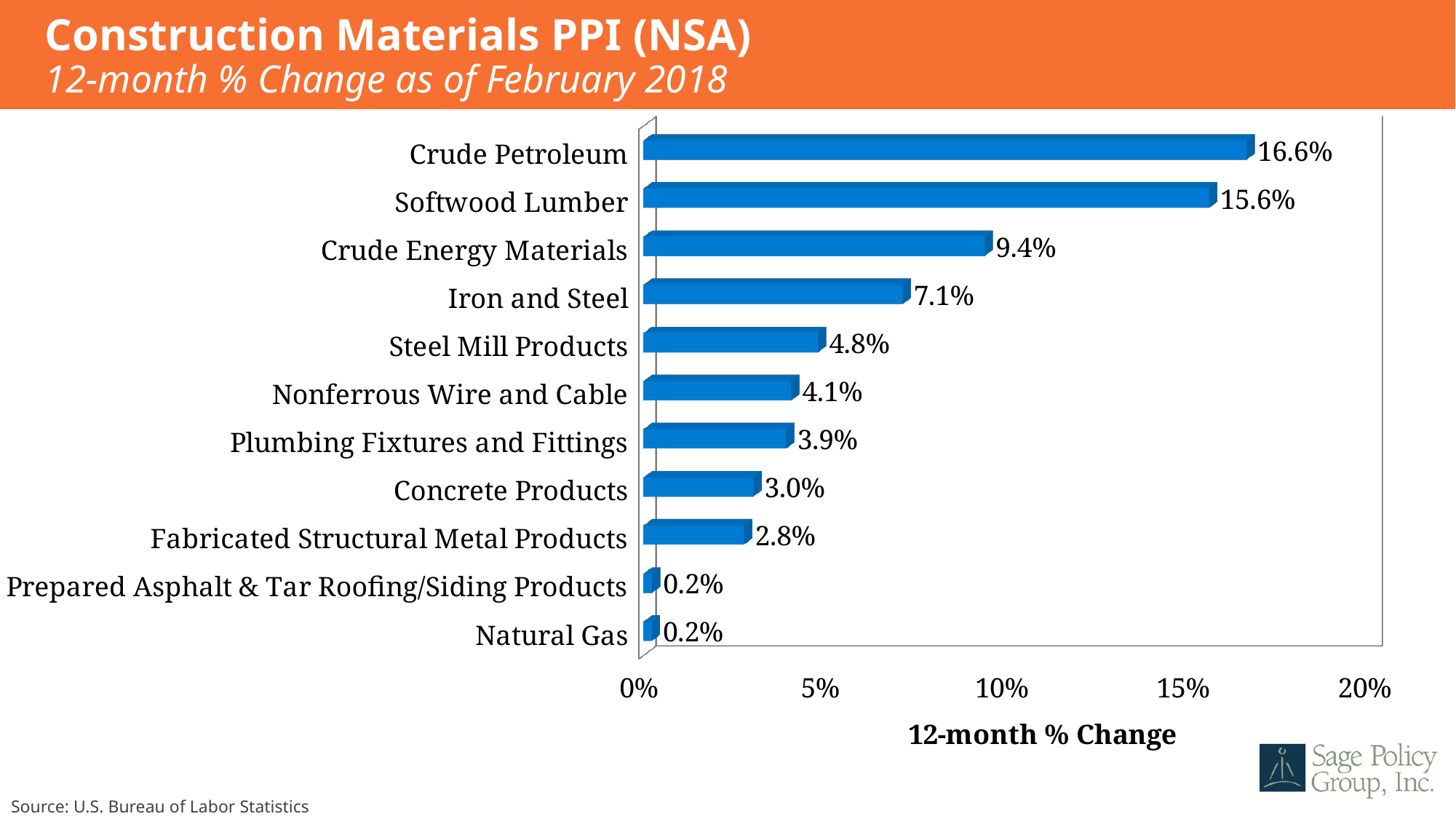
Is the value for Softwood Lumber greater or less than 15%? greater What is the difference between the 12-month % change for Crude Petroleum and Softwood Lumber? 1.0% How many categories are shown in the chart? 11 What kind of chart is shown on the slide? Bar chart Which has a larger 12-month % change, Steel Mill Products or Nonferrous Wire and Cable? Steel Mill Products What is the difference between the 12-month % change for Crude Energy Materials and Iron and Steel? 2.3% Which category has the highest 12-month % change? Crude Petroleum What is the 12-month % change for Iron and Steel? 7.1% What is the 12-month % change for Concrete Products? 3.0% What is the 12-month % change for Crude Petroleum? 16.6% What is the title of the chart? Construction Materials PPI (NSA) What is the label on the horizontal axis? 12-month % Change